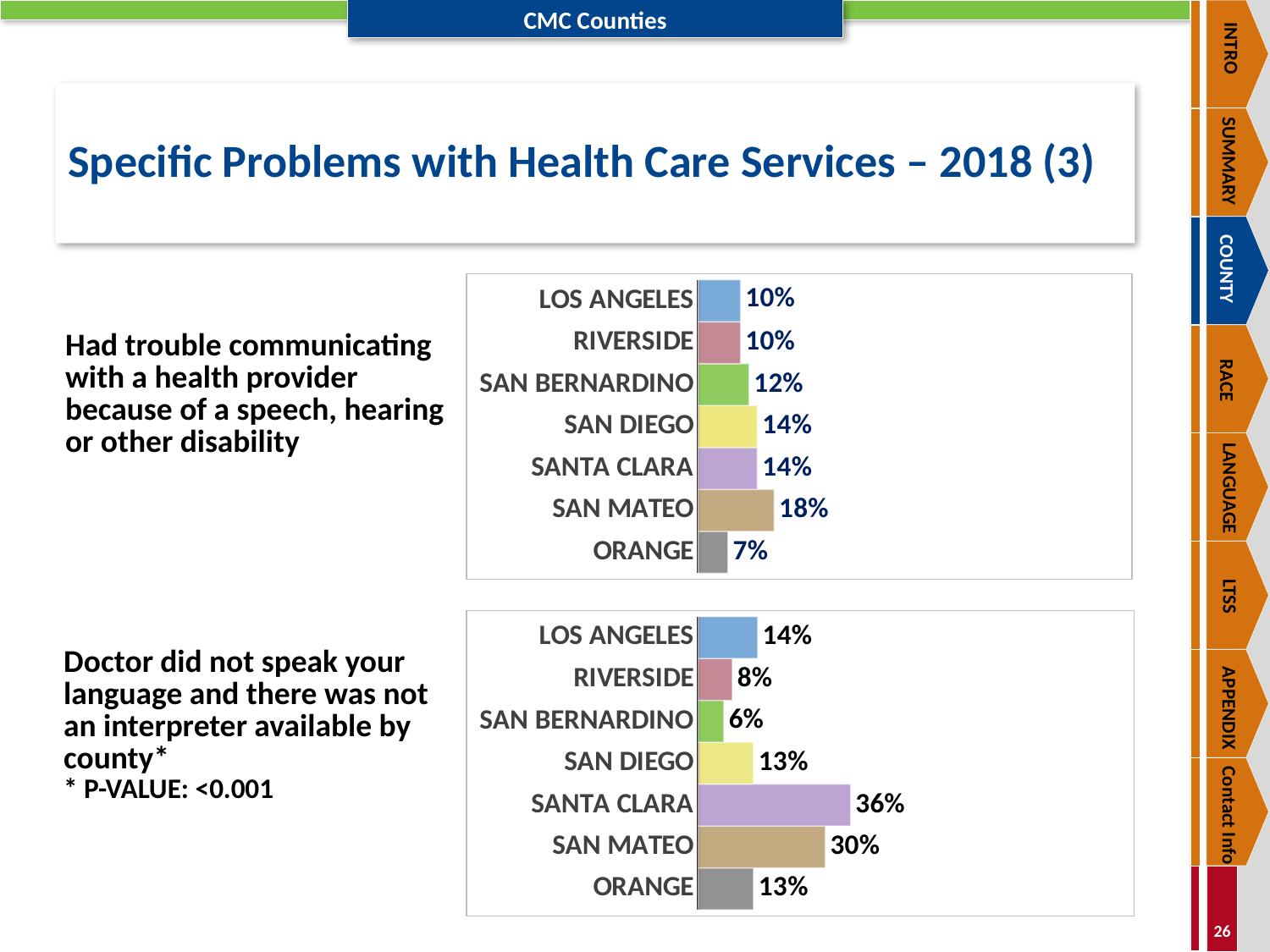
In the top chart (trouble communicating because of a disability), which county has the lowest value? Orange In the bottom chart (doctor did not speak your language), which county has the lowest value? San Bernardino In the top chart (trouble communicating because of a disability), what is the difference between San Mateo and Orange? 11% In the top chart (trouble communicating because of a disability), what is the value for San Mateo? 18% In the bottom chart (doctor did not speak your language), what is the value for Orange? 13% In the bottom chart (doctor did not speak your language), which is larger, Los Angeles or Riverside? Los Angeles In the bottom chart (doctor did not speak your language), what is the value for Santa Clara? 36% In the top chart (trouble communicating because of a disability), how many counties are shown? 7 In the top chart (trouble communicating because of a disability), what is the value for San Bernardino? 12% What type of chart is the bottom chart (doctor did not speak your language)? Bar chart In the top chart (trouble communicating because of a disability), which county has the highest value? San Mateo In the bottom chart (doctor did not speak your language), what is the difference between Santa Clara and San Mateo? 6%